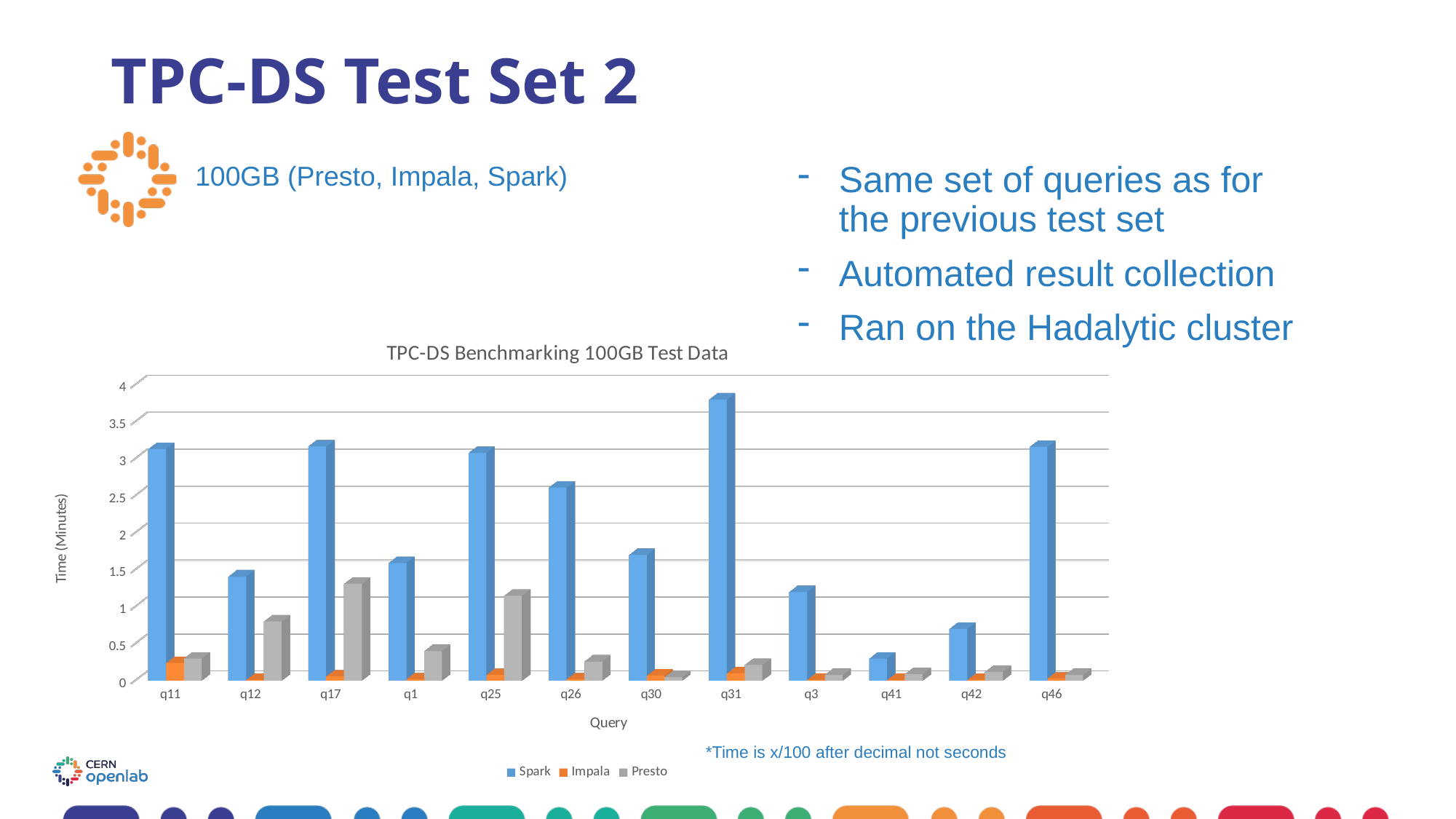
What is the label of the y axis of the chart? Time (Minutes) Which query has the highest Spark time in the chart? q31 Is the Spark value for q31 greater or less than 3.5? greater What kind of chart is shown on the slide? bar chart Which is larger, the Presto value for q12 or the Presto value for q1? q12 Is the Spark value for q41 greater or less than 0.5? less Is the Presto value for q17 greater or less than 1? greater Which is larger, the Spark value for q26 or the Spark value for q30? q26 What is the title of the chart? TPC-DS Benchmarking 100GB Test Data Which query has the highest Presto time in the chart? q17 How many series does the chart legend list? 3 How many queries are shown on the x axis of the chart? 12